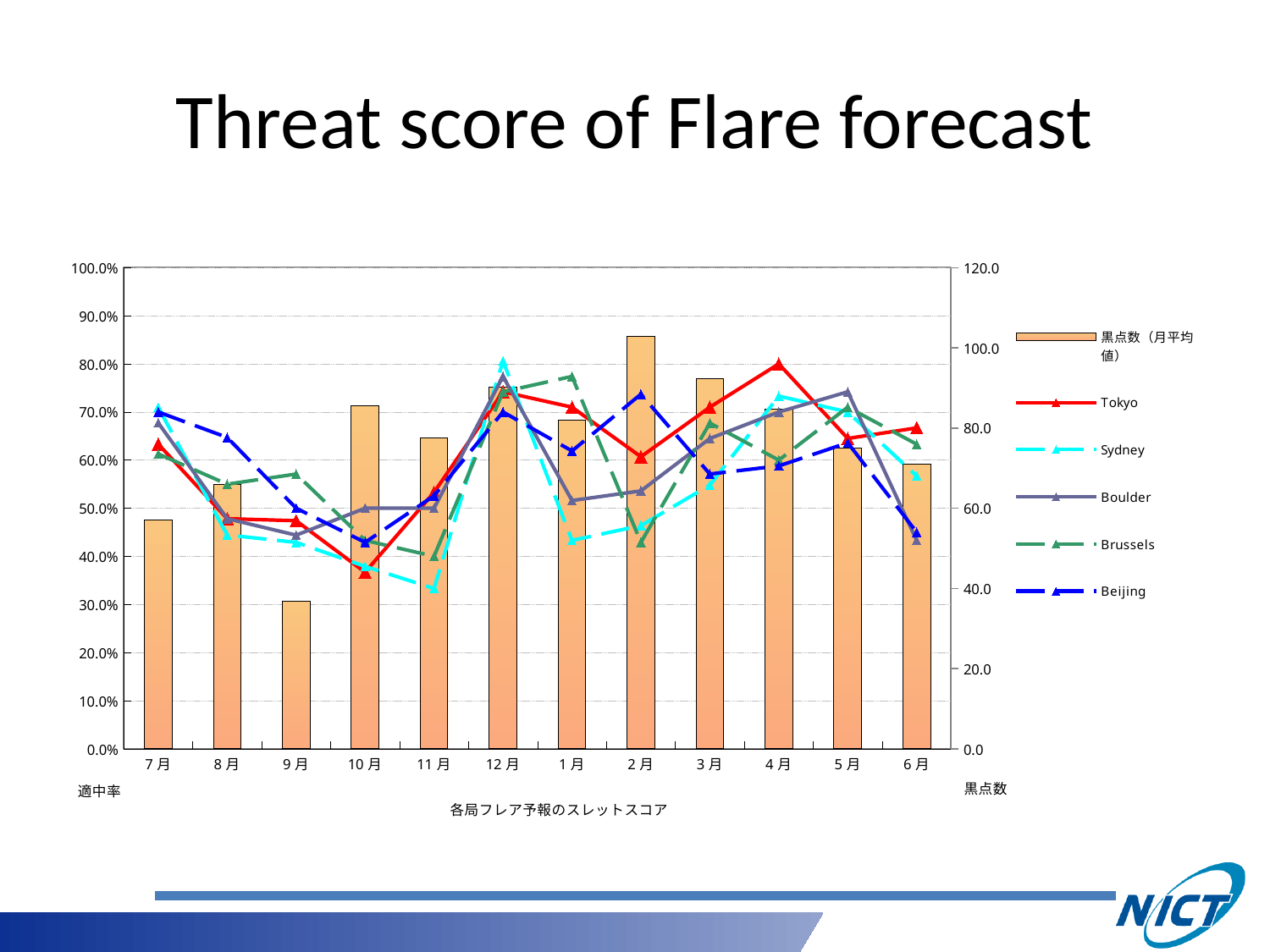
In which month does the Tokyo line reach its highest value? 4月 Is the bar value (黒点数) for 9月 greater or less than 60.0? less Is the Tokyo value for 4月 greater or less than 70.0%? greater How many months are shown along the x axis of the chart? 12 Do the bar values (黒点数) rise or fall from 2月 to 6月? fall What kind of chart is shown on the slide? A combined bar and line chart Which is larger in 1月, the Tokyo value or the Sydney value? Tokyo How many series does the chart's legend list? 6 Which series in the legend is drawn in red? Tokyo Is the Sydney value for 11月 greater or less than 40.0%? less In which month is the bar (黒点数) lowest? 9月 In which month is the bar (黒点数) highest? 2月